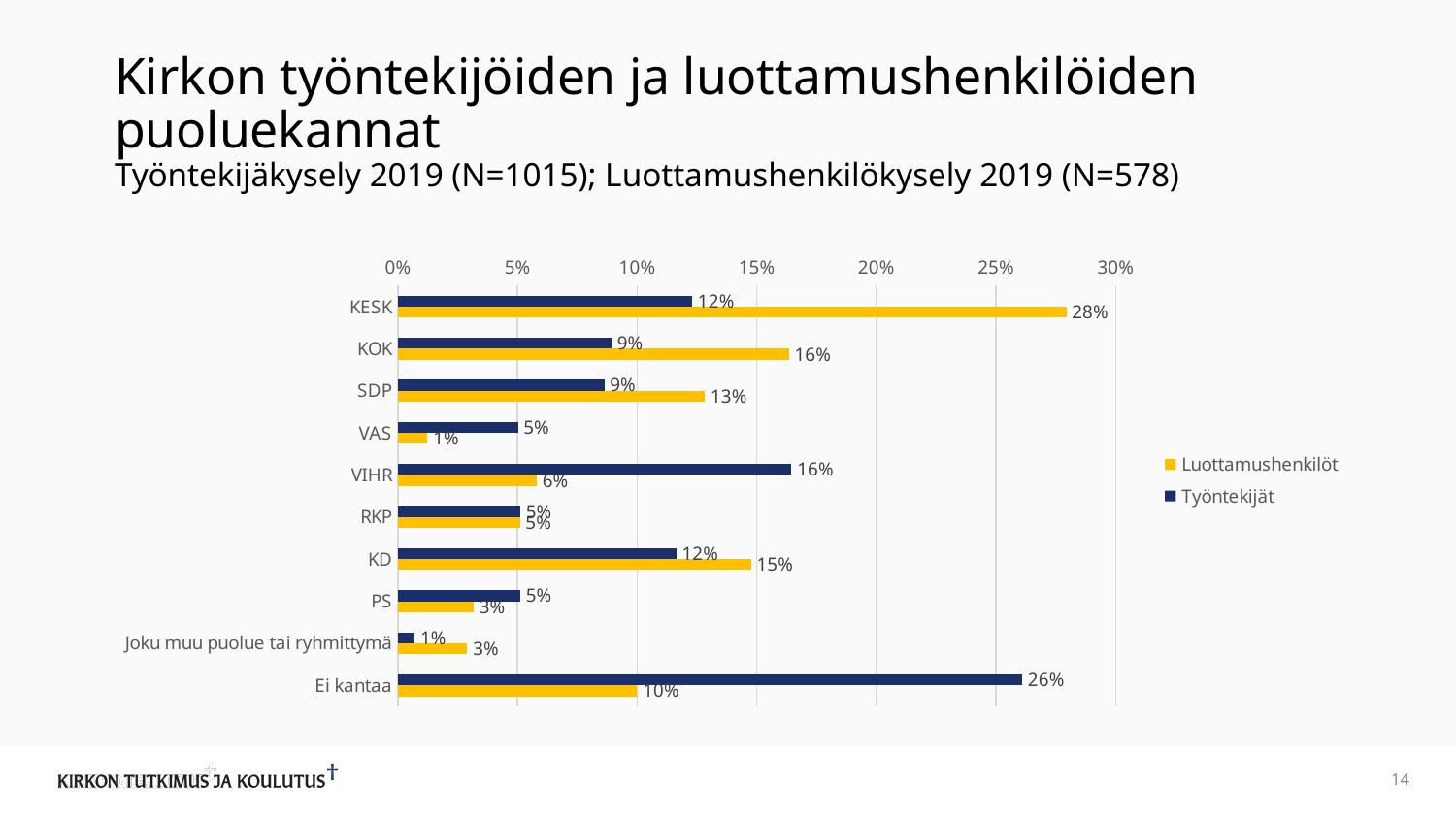
Which category has the lowest Luottamushenkilöt value? VAS What kind of chart is shown on the slide? Bar chart How many series does the legend list? 2 What is the difference between the Luottamushenkilöt and Työntekijät values for KESK? 16% What is the Työntekijät value for Ei kantaa? 26% Which is larger for KD: the Luottamushenkilöt value or the Työntekijät value? Luottamushenkilöt How many categories are shown on the chart? 10 What is the Luottamushenkilöt value for KESK? 28% Is the Työntekijät value for Ei kantaa greater or less than 25%? greater Which category has the highest Luottamushenkilöt value? KESK What is the Työntekijät value for VIHR? 16% What is the difference between the Työntekijät and Luottamushenkilöt values for Ei kantaa? 16%